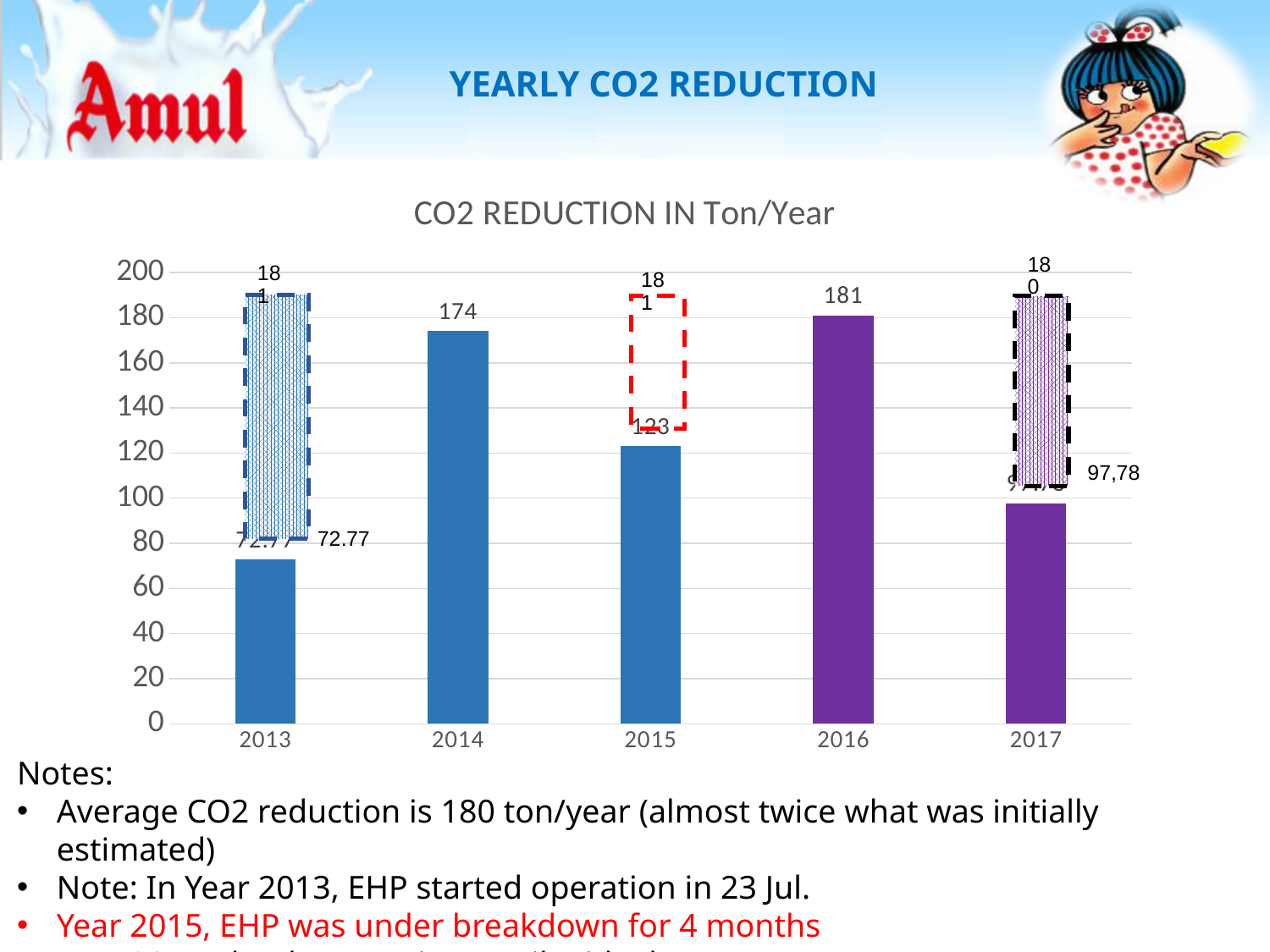
What is the CO2 reduction value shown for 2015? 123 Which year has the lowest CO2 reduction? 2013 How many years are shown on the x axis of the chart? 5 What is the CO2 reduction value shown for 2014? 174 What is the difference between the CO2 reduction in 2016 and in 2014? 7 What is the CO2 reduction value shown for 2016? 181 What is the difference between the CO2 reduction in 2014 and in 2015? 51 Which year has the highest CO2 reduction? 2016 What kind of chart is used to show the CO2 reduction? bar chart What is the CO2 reduction value shown for 2013? 72.77 Is the value for 2017 greater or less than 100? less Which year has a larger CO2 reduction, 2015 or 2017? 2015